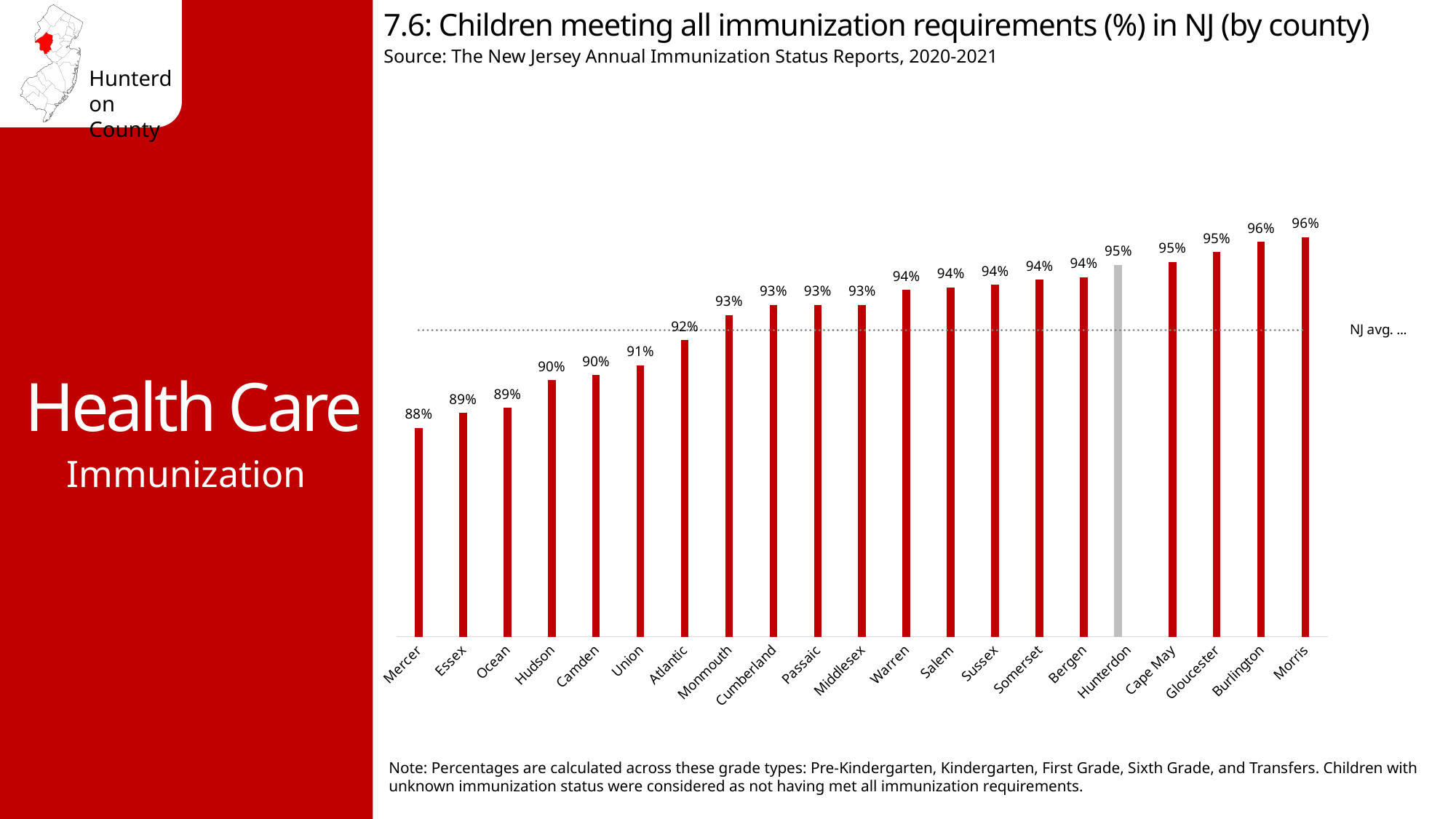
Which has a higher value, Atlantic County or Union County? Atlantic What kind of chart is used on this slide? Bar chart Which has a higher value, Hunterdon County or Essex County? Hunterdon What is the difference in percentage points between Hunterdon County and Mercer County? 7 percentage points Which county has the lowest percentage of children meeting all immunization requirements? Mercer Do the values generally rise or fall moving from left to right along the x axis? Rise How many counties are shown on the chart? 21 What is the value shown for Mercer County? 88% What is the value shown for Cumberland County? 93% What percentage of children in Hunterdon County met all immunization requirements? 95% What is the value shown for Atlantic County? 92% What is the difference in percentage points between Morris County and Mercer County? 8 percentage points